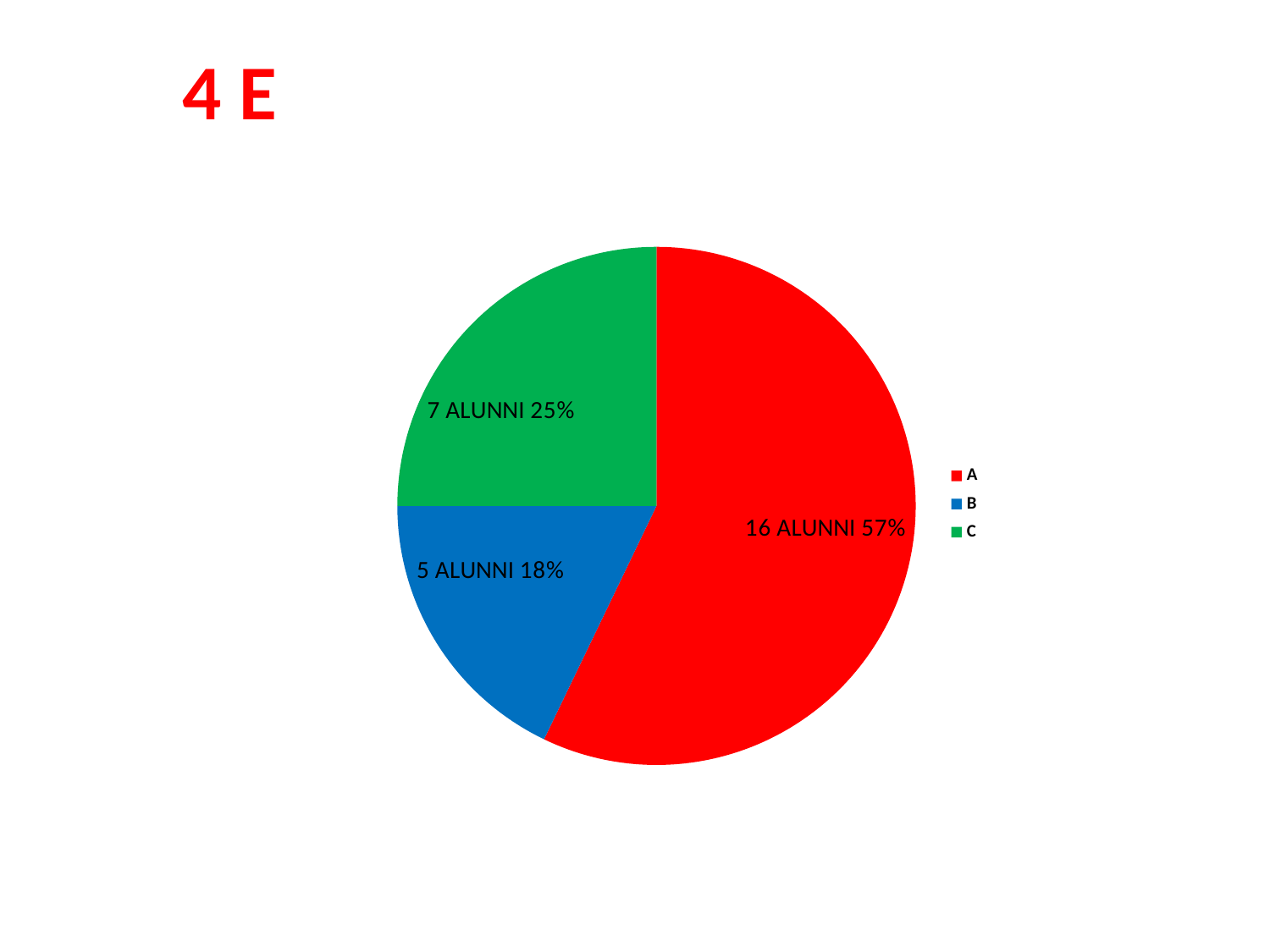
What is the data label for slice B? 5 ALUNNI 18% What kind of chart is shown on the slide? pie chart Which slice has more alunni, B or C? C What is the data label for slice A? 16 ALUNNI 57% How many entries does the legend list? 3 How many slices does the pie chart have? 3 What percentage share of the pie does slice C represent? 25% Which slice is the smallest? B What percentage share of the pie does slice A represent? 57% Which slice is the largest? A What is the data label for slice C? 7 ALUNNI 25% How many more alunni are in slice A than in slice C? 9